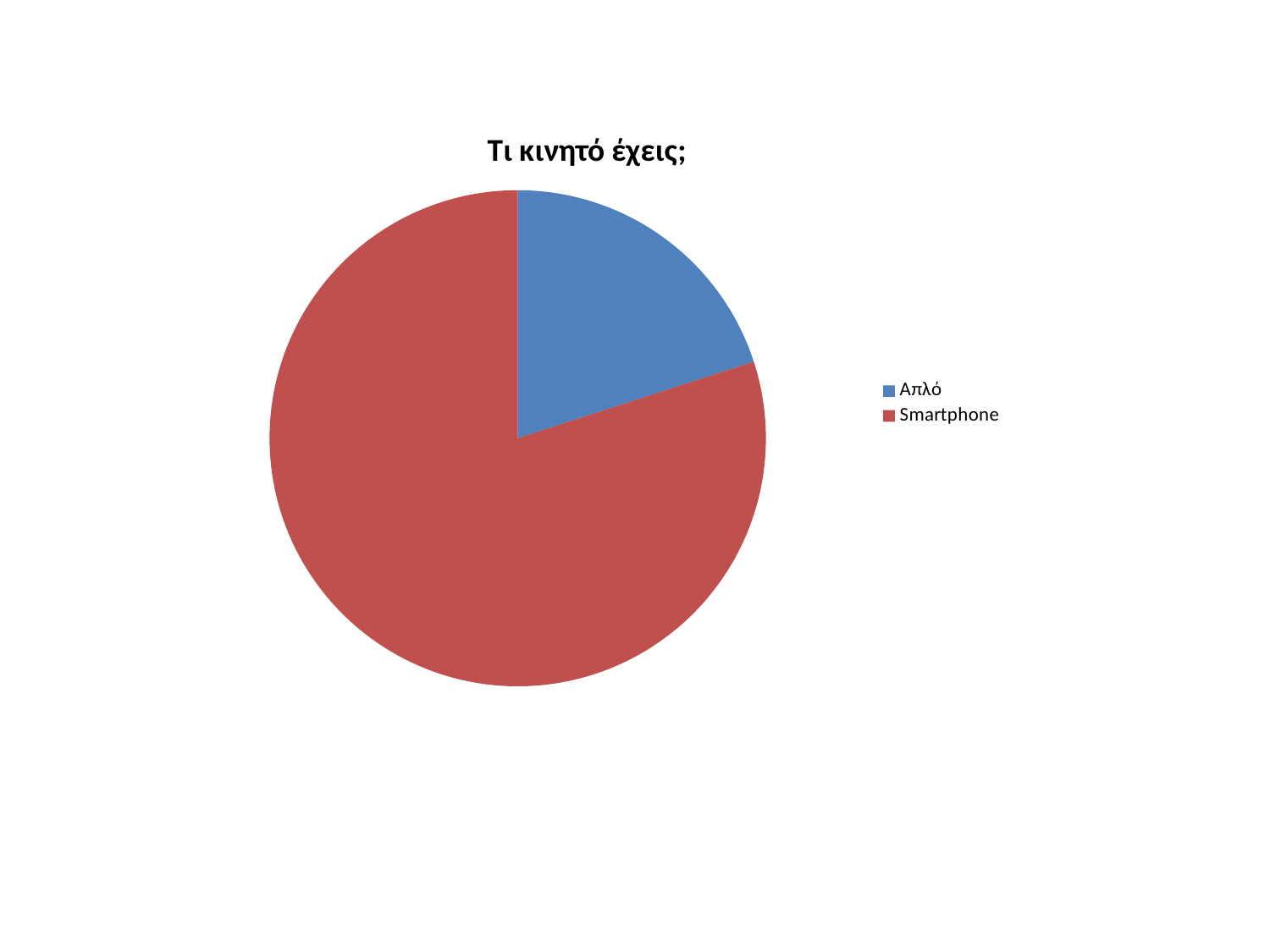
What kind of chart is shown on the slide? pie chart Which category has the smallest slice of the pie? Απλό Which slice is larger, Απλό or Smartphone? Smartphone What is the title of the chart? Τι κινητό έχεις; Which category has the largest slice of the pie? Smartphone How many slices does the pie chart have? 2 What colour is the Smartphone slice? red How many entries does the legend list? 2